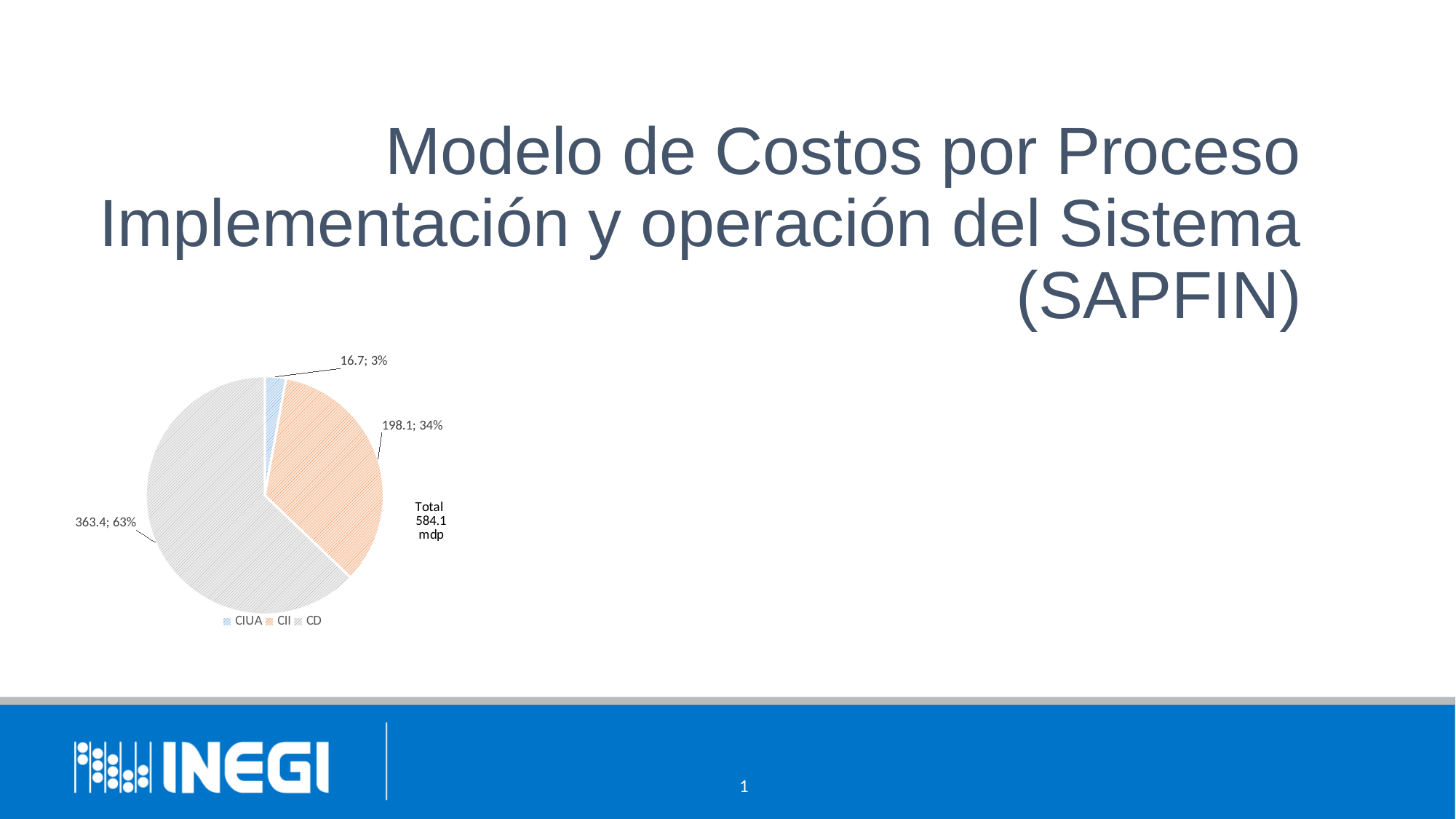
What is the value shown for the CIUA slice? 16.7 What is the difference between the values for CD and CII? 165.3 What is the value shown for the CII slice? 198.1 How many slices does the pie chart have? 3 Which slice of the pie chart is the smallest? CIUA What is the value shown for the CD slice? 363.4 What share of the pie does the CD slice represent? 63% What kind of chart is shown on the slide? pie chart What total is printed next to the pie chart? 584.1 mdp Which slice of the pie chart is the largest? CD What share of the pie does the CII slice represent? 34% How many entries does the legend of the pie chart list? 3